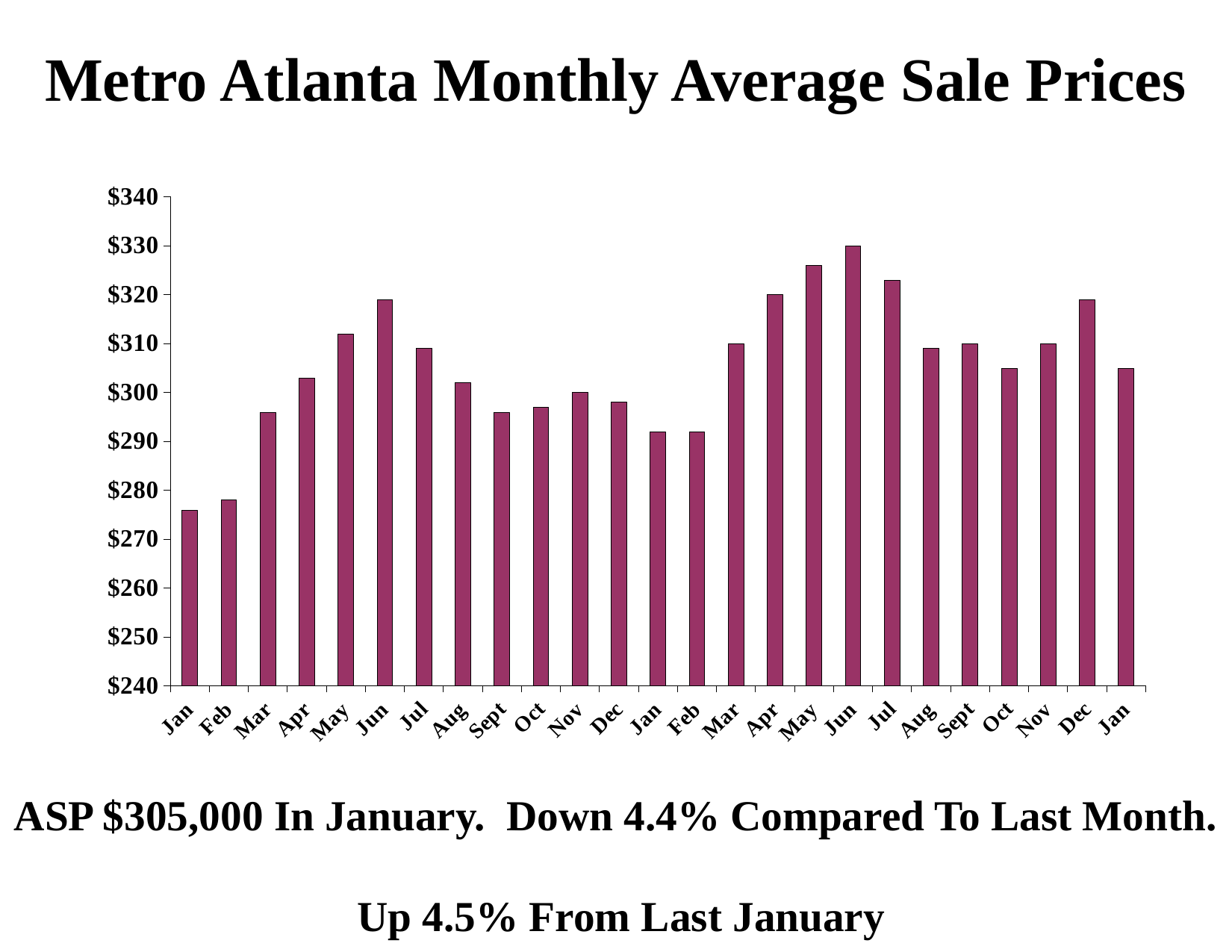
Is the value for the second Feb bar greater or less than $300? less How many bars (months) are plotted in the chart? 25 According to the text on the slide, what was the ASP in the most recent January? $305,000 Which is larger, the value for the first Mar bar or the second Mar bar? the second Mar bar Which month has the highest average sale price in the chart? the second Jun Is the value for the leftmost Jan bar greater or less than $280? less Which month has the lowest average sale price in the chart? the first Jan (leftmost bar) What is the title of the chart? Metro Atlanta Monthly Average Sale Prices Is the value for the second Jun bar greater or less than $320? greater Which is larger, the value for the first Jun bar or the second Jun bar? the second Jun bar What type of chart is shown on the slide? bar chart Do the values rise or fall from the first Jan bar to the first Jun bar? rise